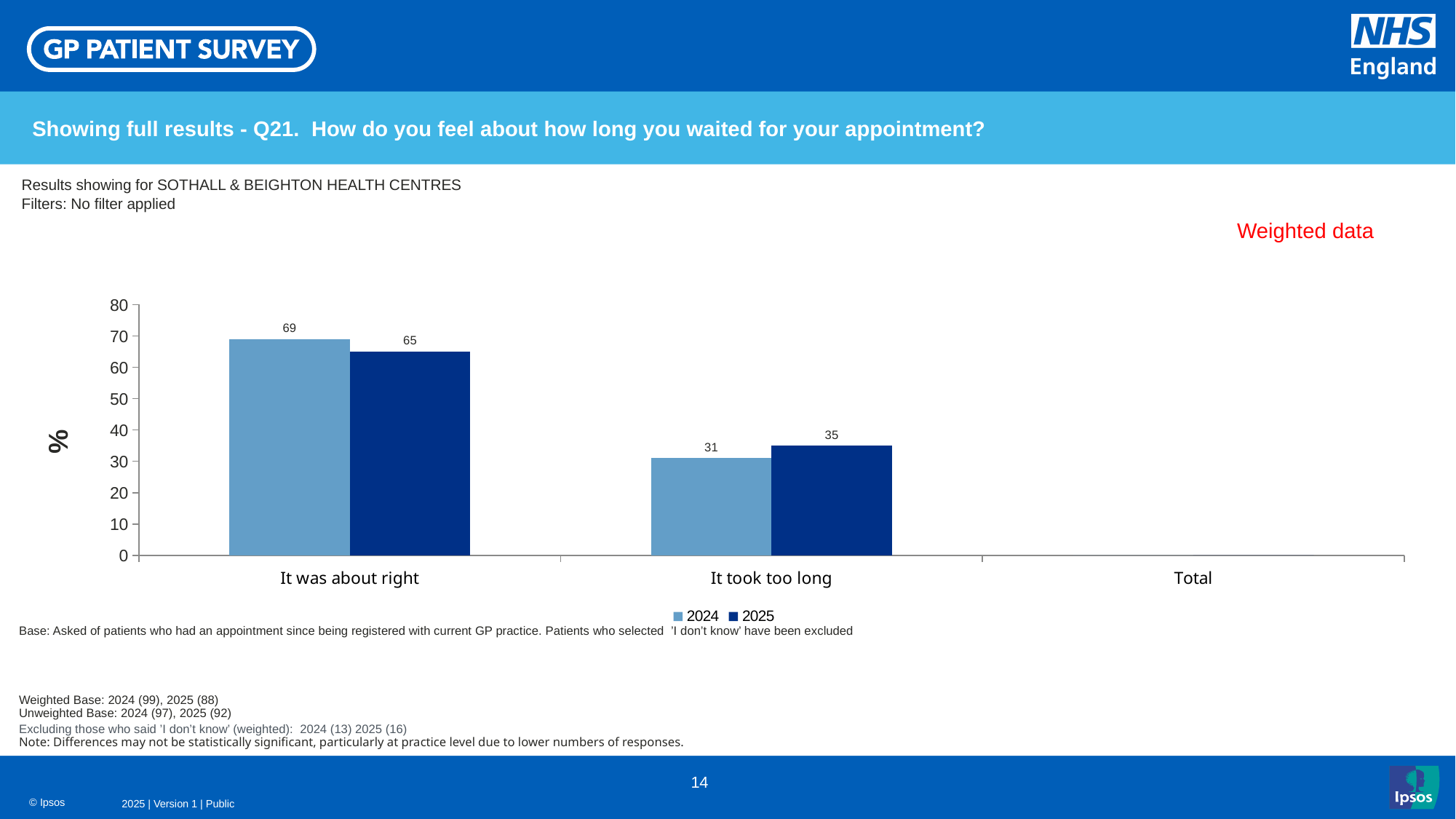
Which category has the highest 2025 value? It was about right What is the 2024 value for 'It was about right'? 69 What is the label on the vertical axis of the chart? % Which is larger for 'It took too long': the 2024 value or the 2025 value? 2025 What kind of chart is shown on the slide? Bar chart What is the difference between the 2024 and 2025 values for 'It was about right'? 4 How many series does the legend list? 2 What is the 2025 value for 'It was about right'? 65 What is the 2024 value for 'It took too long'? 31 What is the 2025 value for 'It took too long'? 35 Is the 2025 value for 'It was about right' greater or less than 60? greater Which category has the lowest 2024 value? It took too long